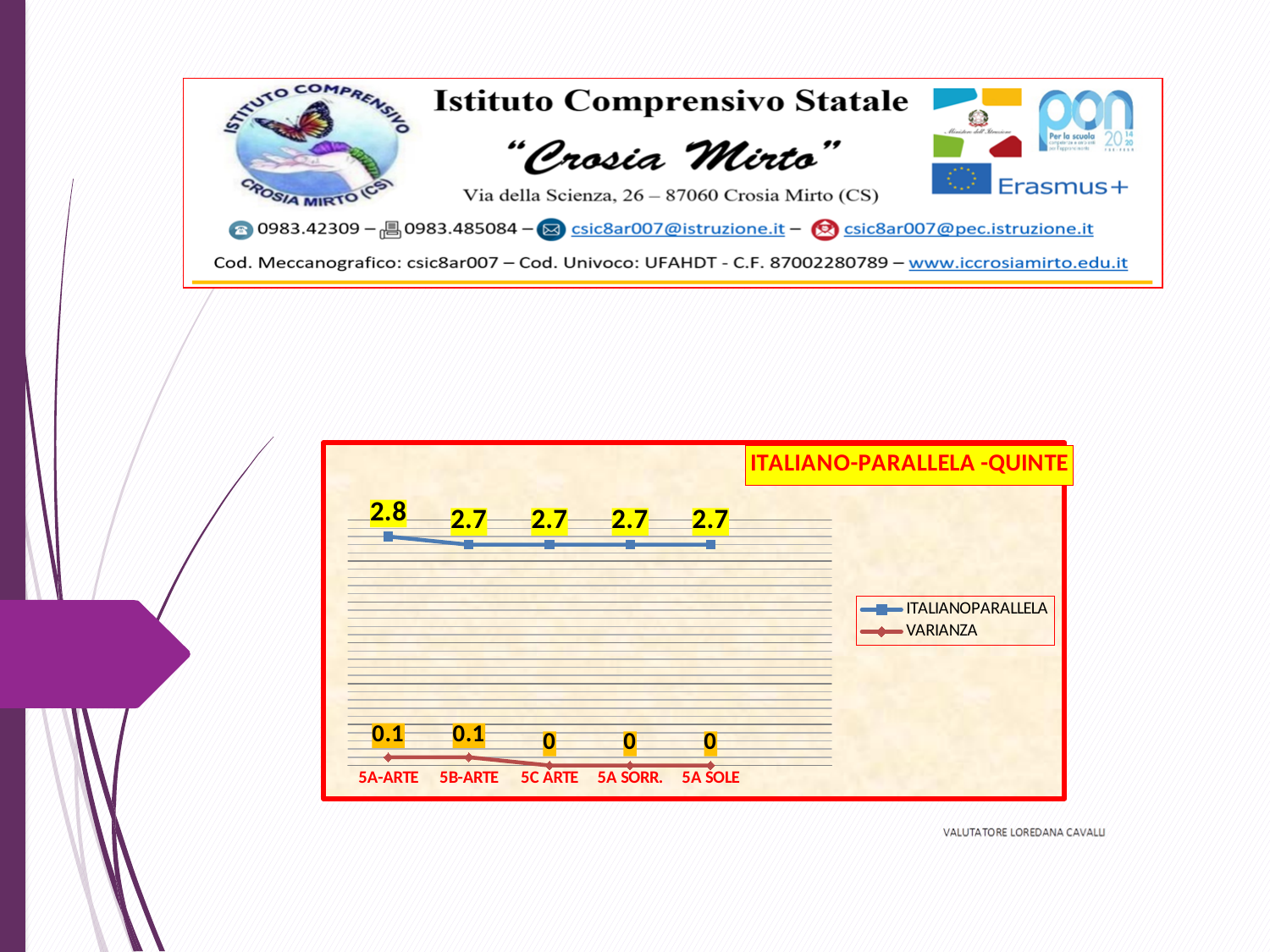
What kind of chart is shown on the slide? line chart What is the title of the chart? ITALIANO-PARALLELA -QUINTE What is the ITALIANOPARALLELA value for 5A SORR.? 2.7 What is the ITALIANOPARALLELA value for 5A-ARTE? 2.8 How many categories are shown on the x axis? 5 What is the VARIANZA value for 5A SOLE? 0 Does the VARIANZA series rise or fall from 5A-ARTE to 5A SOLE? fall How many series does the legend list? 2 What is the difference between the ITALIANOPARALLELA values for 5A-ARTE and 5B-ARTE? 0.1 What is the VARIANZA value for 5B-ARTE? 0.1 Which is larger, the VARIANZA value for 5A-ARTE or for 5C ARTE? 5A-ARTE Which category has the highest ITALIANOPARALLELA value? 5A-ARTE